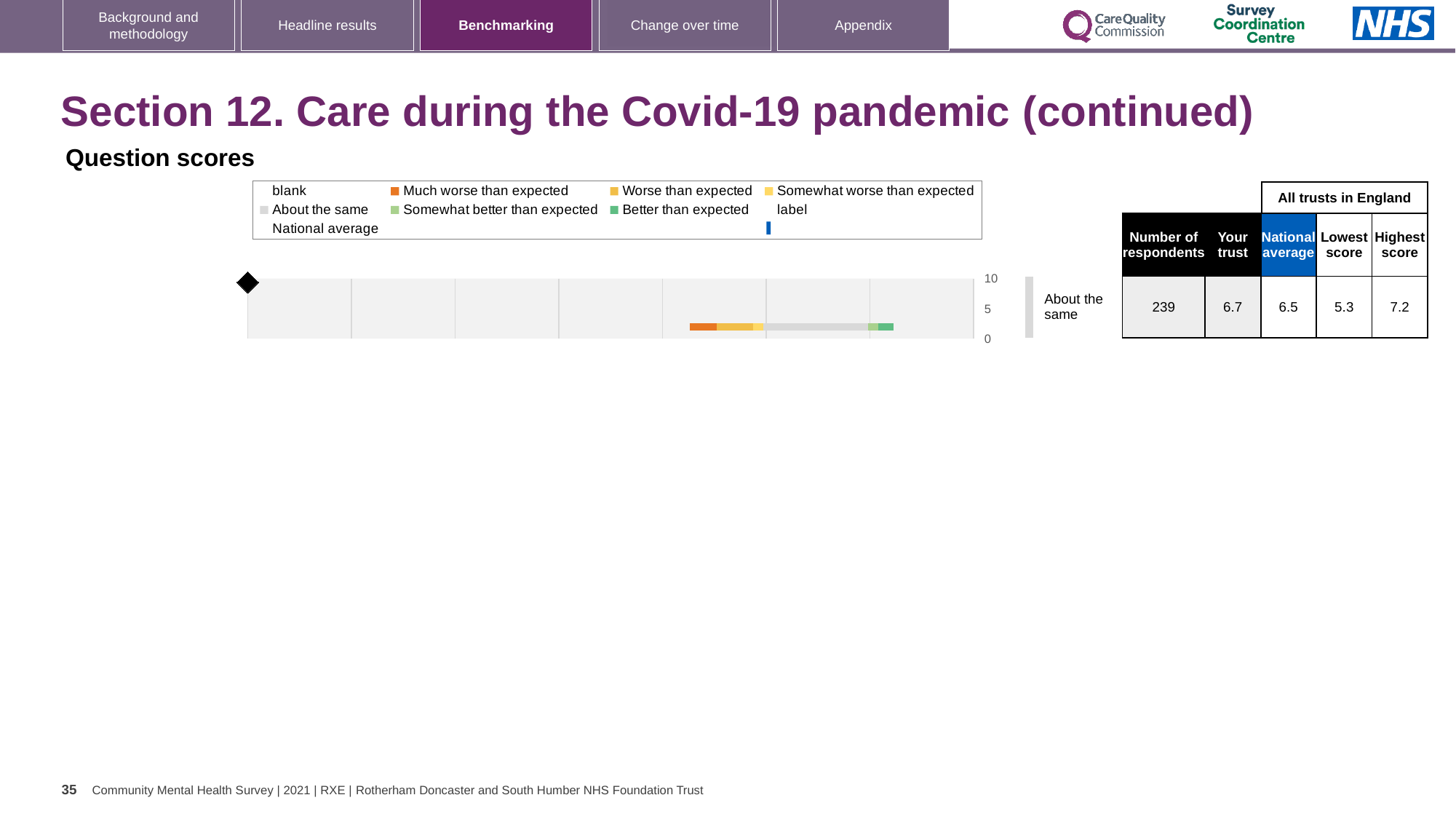
In the table beside the chart, what is the 'Your trust' score for the 'About the same' row? 6.7 What is the category label shown next to the plotted bar? About the same What kind of chart is shown under 'Question scores'? bar chart What is the highest tick value shown on the chart's axis? 10 Which is larger for the 'About the same' row: the 'Your trust' score or the National average? Your trust In the table beside the chart, what is the Highest score among all trusts in England? 7.2 In the table beside the chart, what is the Lowest score among all trusts in England? 5.3 In the table beside the chart, how many respondents are listed for the 'About the same' row? 239 What is the difference between the Highest score and the Lowest score shown in the table? 1.9 In the table beside the chart, what is the National average score for the 'About the same' row? 6.5 Which legend entry is shown in orange? Much worse than expected How many bars (question rows) are plotted in the chart? 1